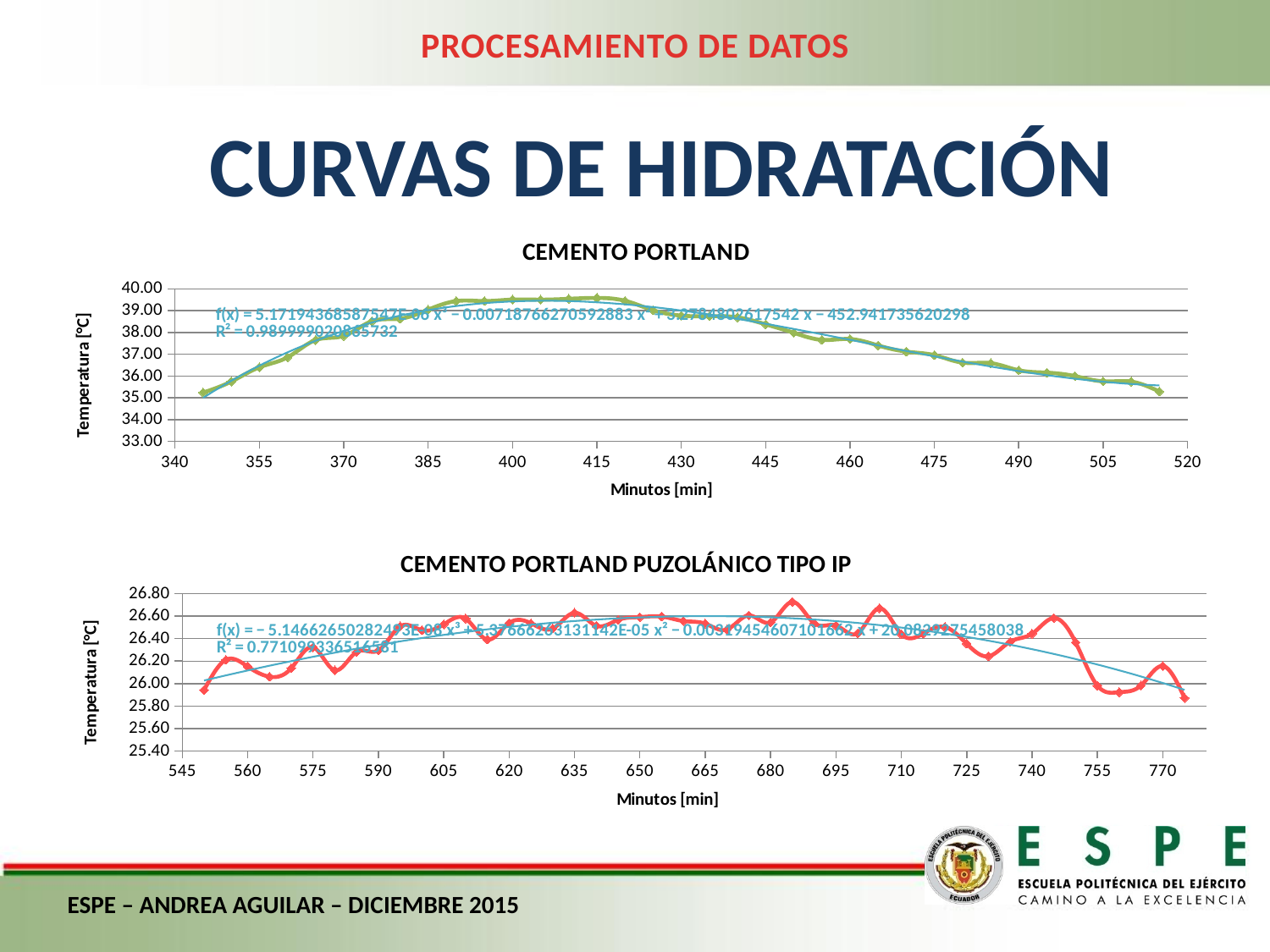
In the "CEMENTO PORTLAND" chart, is the temperature at the first point (around 345 minutes) greater or less than 36.00? less What is the label of the x axis on the "CEMENTO PORTLAND PUZOLÁNICO TIPO IP" chart? Minutos [min] How many charts are shown on the slide? 2 In the "CEMENTO PORTLAND PUZOLÁNICO TIPO IP" chart, is the temperature at the first point (around 550 minutes) greater or less than 26.00? less What kind of chart is the "CEMENTO PORTLAND PUZOLÁNICO TIPO IP" chart? Line chart In the "CEMENTO PORTLAND" chart, do the values rise or fall between 460 and 515 minutes? fall In the "CEMENTO PORTLAND" chart, is the temperature at 490 minutes greater or less than 37.00? less What kind of chart is the "CEMENTO PORTLAND" chart? Line chart In the "CEMENTO PORTLAND" chart, do the values rise or fall between 340 and 400 minutes? rise What is the label of the y axis on the "CEMENTO PORTLAND" chart? Temperatura [°C]